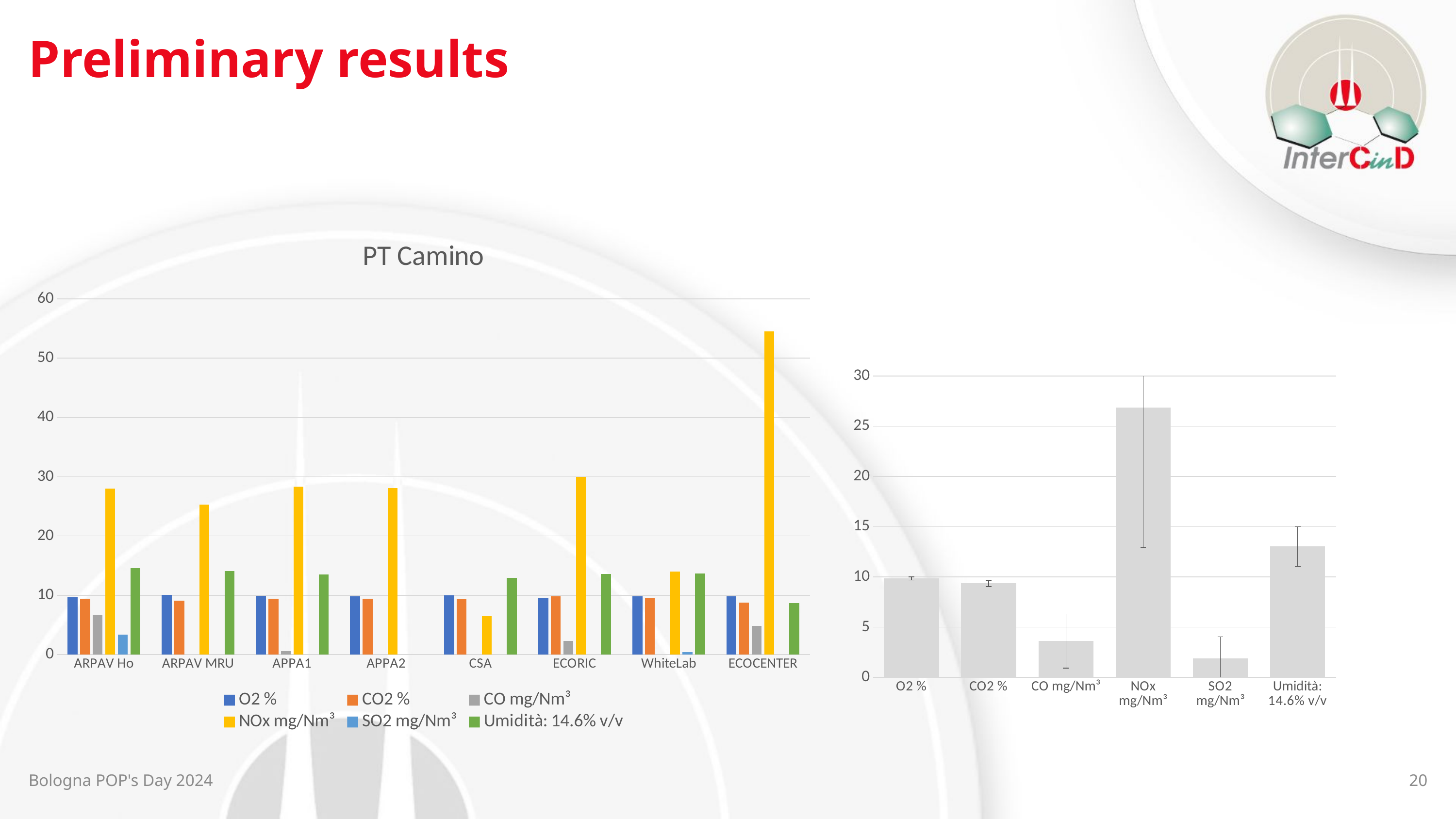
In the PT Camino chart, is the NOx mg/Nm³ value for ECOCENTER larger or smaller than that for ECORIC? larger In the chart on the right, is the value for NOx mg/Nm³ greater or less than 25? greater In the chart on the right, which category has the lowest bar? SO2 mg/Nm³ In the PT Camino chart, is the NOx mg/Nm³ value for ARPAV MRU greater or less than 30? less In the chart on the right, which category has the highest bar? NOx mg/Nm³ What kind of chart is the PT Camino chart on the left? bar chart In the PT Camino chart, which laboratory has the lowest NOx mg/Nm³ value? CSA In the PT Camino chart, which colour represents the NOx mg/Nm³ series? yellow How many series does the legend of the PT Camino chart list? 6 In the PT Camino chart, which laboratory has the highest NOx mg/Nm³ value? ECOCENTER In the PT Camino chart, is the NOx mg/Nm³ value for ECOCENTER greater or less than 50? greater How many laboratories (categories) are shown on the x axis of the PT Camino chart? 8